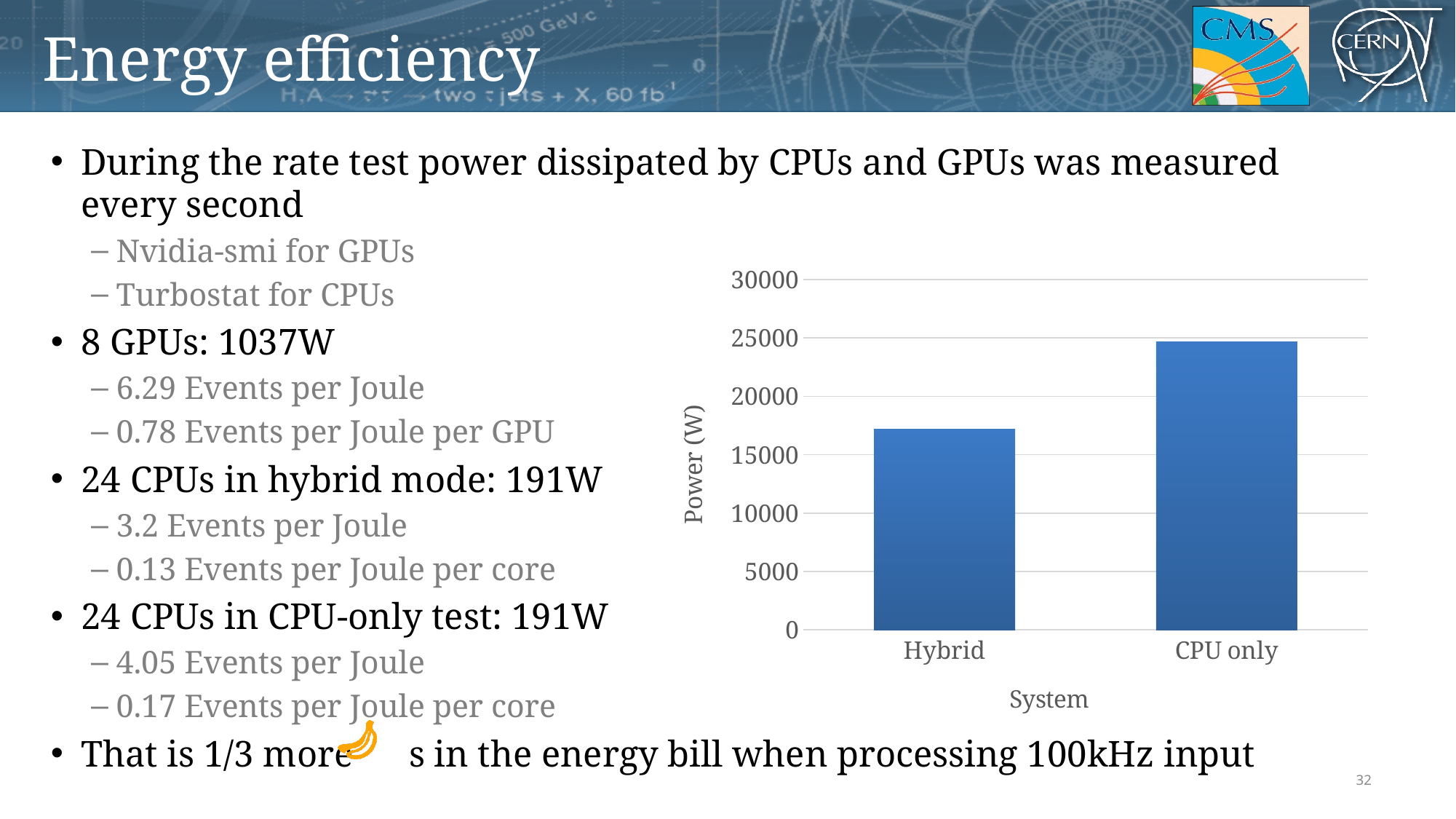
Which system has the highest power in the chart? CPU only Is the power value for CPU only greater or less than 20000? greater Is the power value for Hybrid greater or less than 20000? less Which system has the lowest power in the chart? Hybrid Is the power value for CPU only greater or less than 30000? less How many systems (categories) are plotted in the chart? 2 What kind of chart is shown on the slide? bar chart What is the label of the vertical axis of the chart? Power (W) What is the label of the horizontal axis of the chart? System Which system has the larger power value, Hybrid or CPU only? CPU only